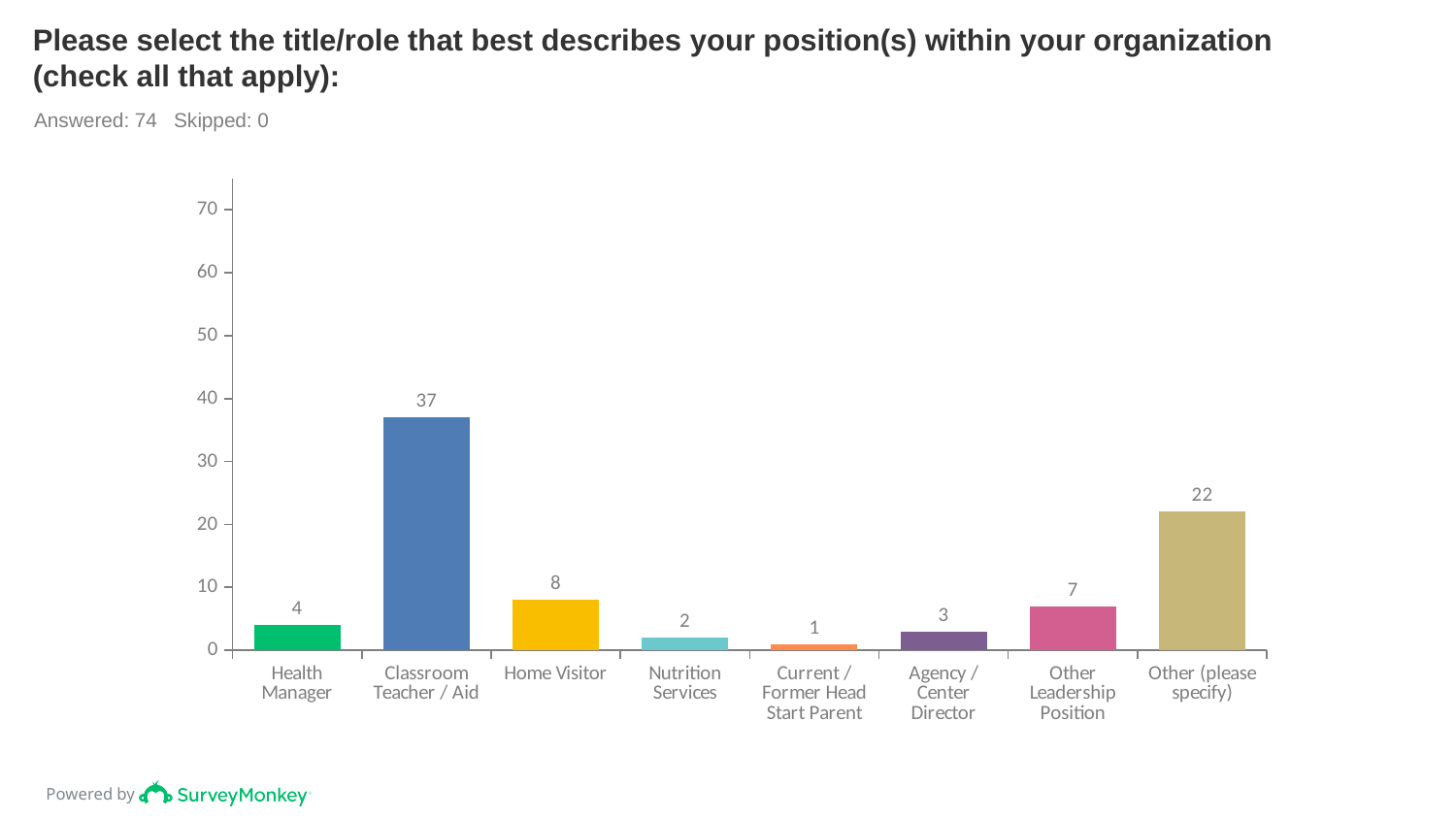
What kind of chart is shown on the slide? bar chart Which category has the highest value? Classroom Teacher / Aid Which is larger, the value for Home Visitor or the value for Other Leadership Position? Home Visitor What is the value for Home Visitor? 8 What is the value for Other (please specify)? 22 What is the value for Agency / Center Director? 3 Is the value for Other (please specify) greater or less than 20? greater How many respondents answered the question according to the slide? 74 What is the value for Classroom Teacher / Aid? 37 How many categories are shown on the x axis? 8 Which category has the lowest value? Current / Former Head Start Parent What is the difference between the values for Classroom Teacher / Aid and Other (please specify)? 15